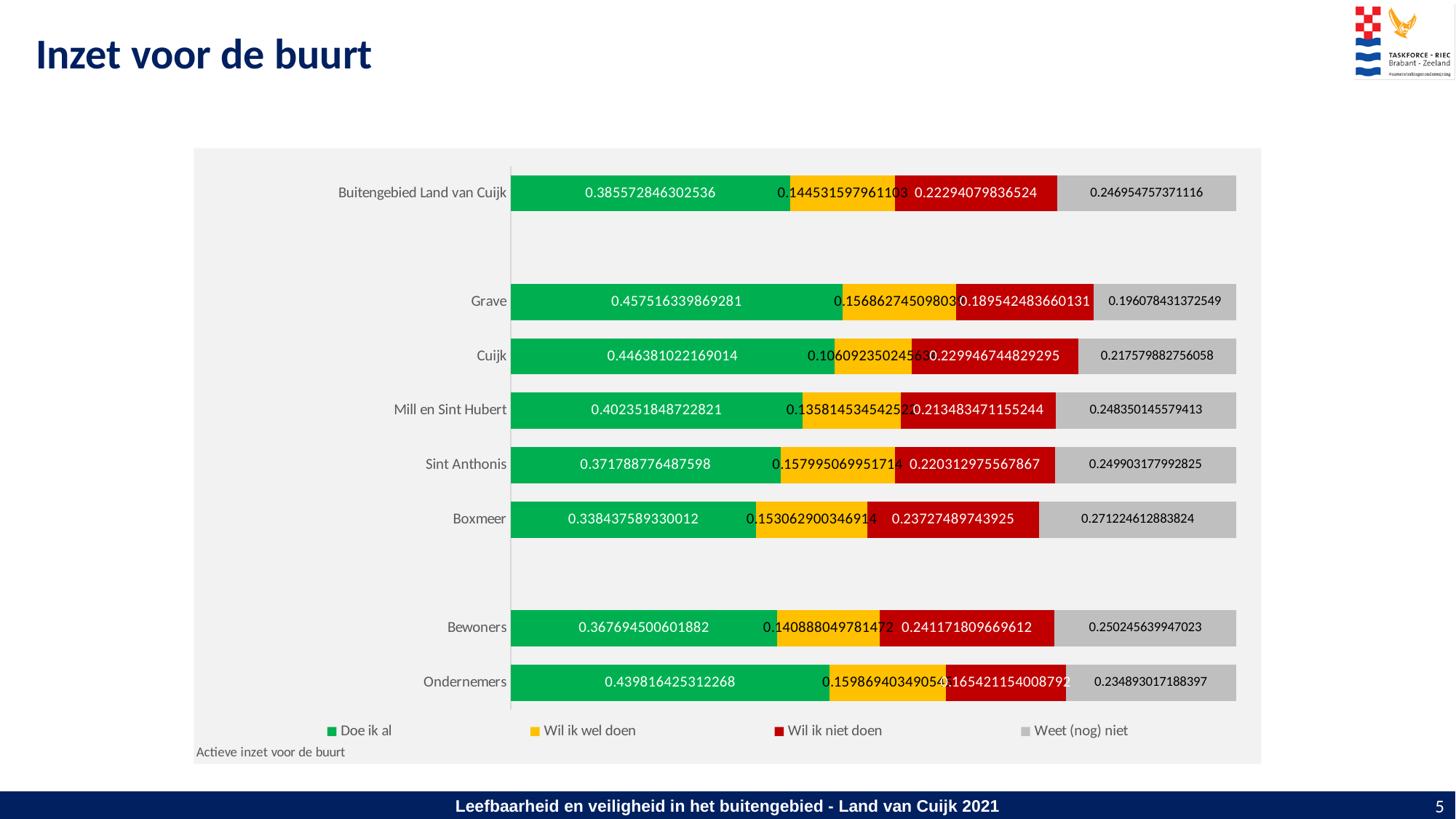
What is the 'Wil ik niet doen' value for Cuijk? 0.229946744829295 What is the title shown below the chart's legend? Actieve inzet voor de buurt Which category has the lowest 'Doe ik al' value? Boxmeer What is the 'Doe ik al' value for Grave? 0.457516339869281 How many series does the legend list? 4 How many categories are plotted on the chart? 8 What is the 'Doe ik al' value for Ondernemers? 0.439816425312268 Which category has the highest 'Doe ik al' value? Grave Which is larger, the 'Doe ik al' value for Cuijk or for Sint Anthonis? Cuijk What kind of chart is shown on the slide? Stacked bar chart What is the 'Weet (nog) niet' value for Boxmeer? 0.271224612883824 Which category has the highest 'Weet (nog) niet' value? Boxmeer